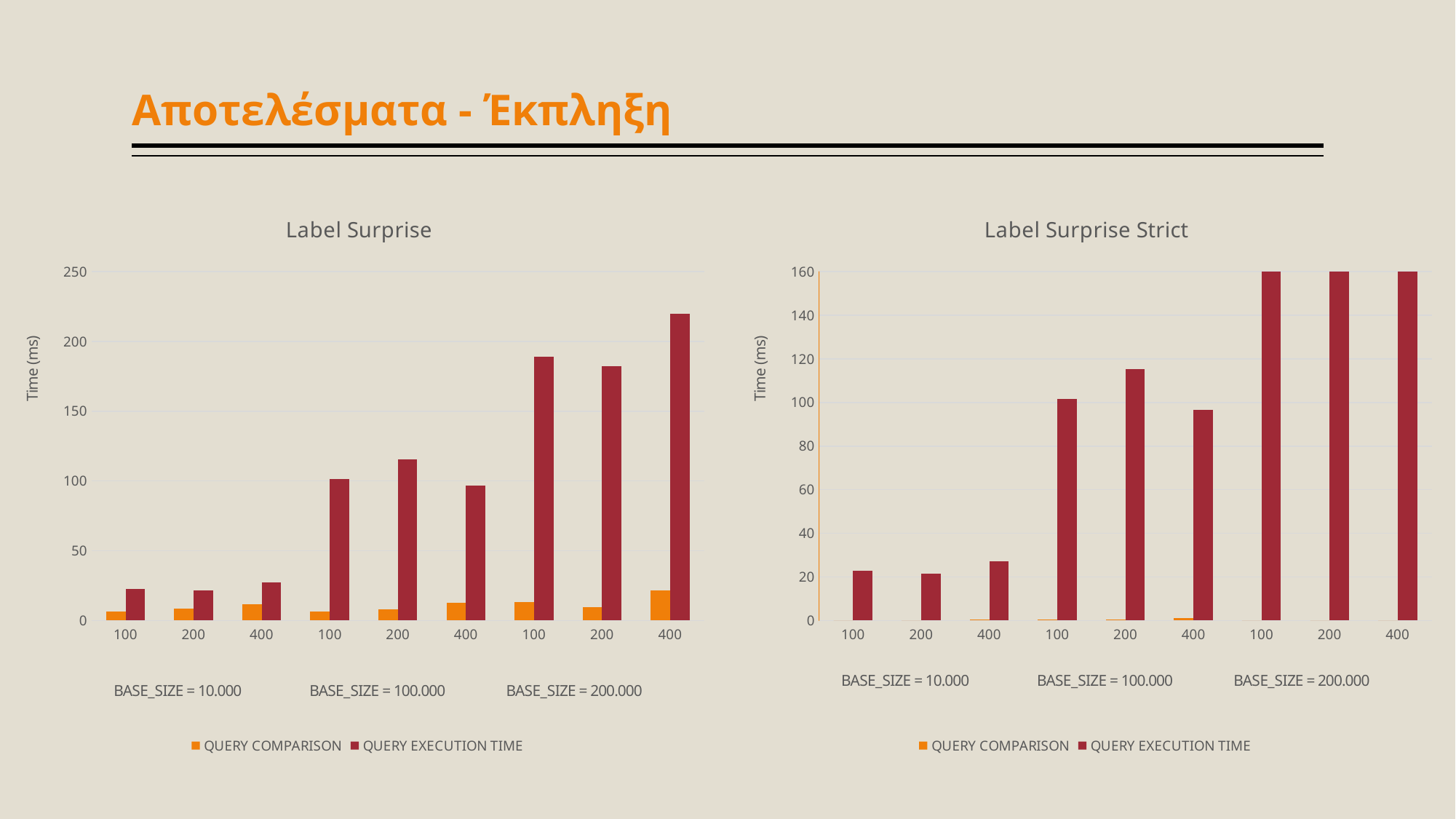
In the "Label Surprise Strict" chart, does the QUERY EXECUTION TIME generally rise or fall as BASE_SIZE increases from 10.000 to 200.000? rise In the "Label Surprise" chart, is the QUERY EXECUTION TIME for 200 at BASE_SIZE = 100.000 greater or less than 100? greater In the "Label Surprise" chart, which bar has the highest QUERY EXECUTION TIME? 400 at BASE_SIZE = 200.000 In the "Label Surprise Strict" chart, is the QUERY EXECUTION TIME for 400 at BASE_SIZE = 10.000 greater or less than 20? greater What kind of chart is the "Label Surprise" chart? bar chart What is the y-axis title of the "Label Surprise Strict" chart? Time (ms) In the "Label Surprise" chart, is the QUERY EXECUTION TIME for 100 at BASE_SIZE = 200.000 greater or less than 150? greater How many series does the legend of the "Label Surprise Strict" chart list? 2 In the "Label Surprise" chart, which bar has the highest QUERY COMPARISON value? 400 at BASE_SIZE = 200.000 In the "Label Surprise" chart, at BASE_SIZE = 100.000, which has the larger QUERY EXECUTION TIME: 200 or 400? 200 How many bars of QUERY EXECUTION TIME are plotted in the "Label Surprise" chart? 9